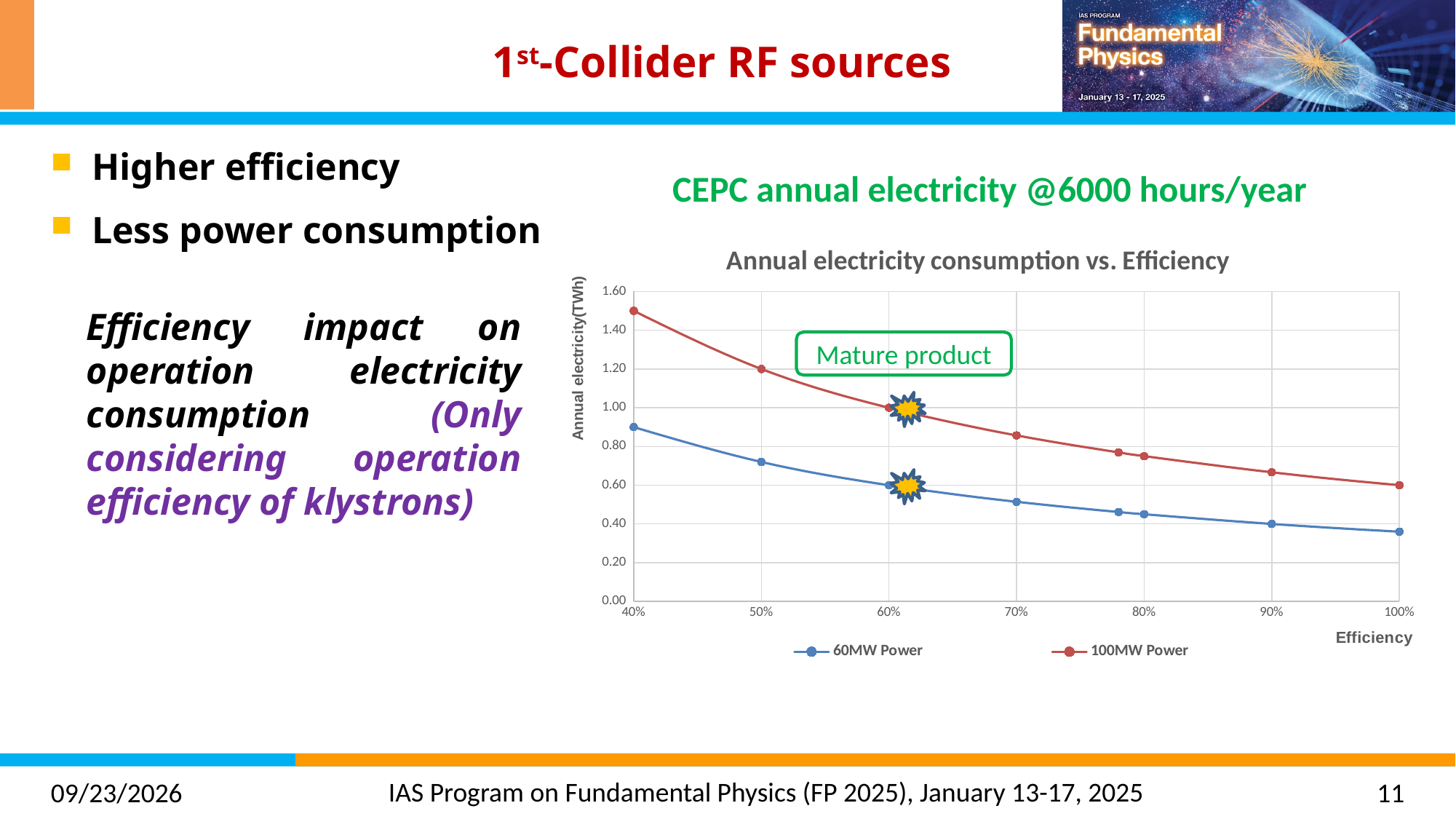
What kind of chart is shown under the title "Annual electricity consumption vs. Efficiency"? line chart At which efficiency is the annual electricity consumption for 100MW Power highest? 40% As efficiency increases along the x axis, do the annual electricity consumption values rise or fall? fall Is the value for 100MW Power at 70% efficiency greater or less than 0.80? greater At which efficiency is the annual electricity consumption for 60MW Power lowest? 100% What are the two series named in the chart legend? 60MW Power and 100MW Power Is the value for 60MW Power at 100% efficiency greater or less than 0.40? less Is the value for 100MW Power at 40% efficiency greater or less than 1.40? greater What is the label of the vertical axis of the chart? Annual electricity(TWh) At 60% efficiency, which series has the higher annual electricity consumption, 60MW Power or 100MW Power? 100MW Power How many series does the legend of the chart list? 2